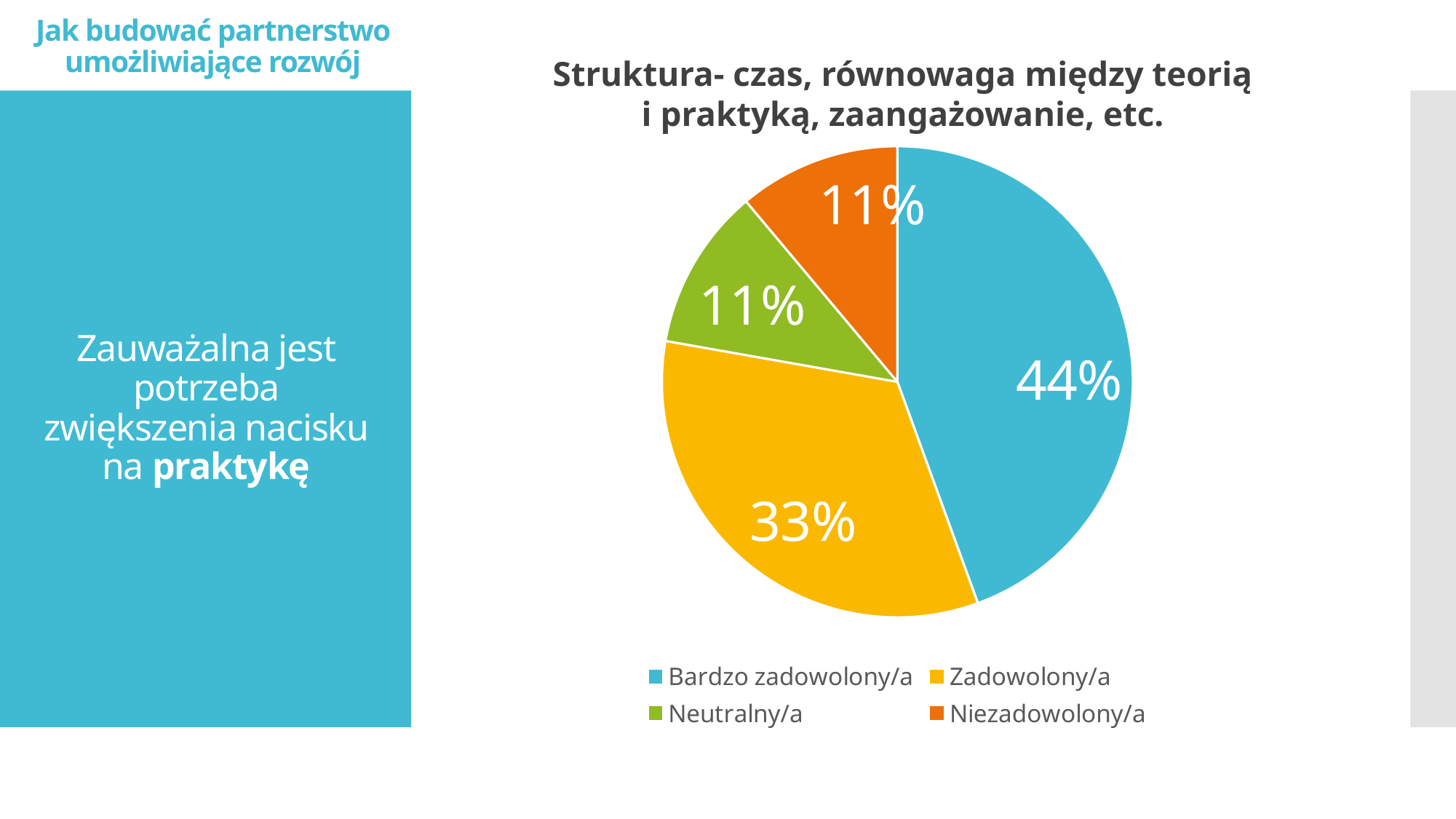
What is the difference in percentage points between Bardzo zadowolony/a and Zadowolony/a? 11 How many slices does the pie chart have? 4 What share of the pie is labelled Niezadowolony/a? 11% What is the title of the pie chart? Struktura- czas, równowaga między teorią i praktyką, zaangażowanie, etc. What share of the pie is labelled Zadowolony/a? 33% Which category has the largest slice of the pie? Bardzo zadowolony/a How many entries does the legend list? 4 What kind of chart is shown on the slide? pie chart What share of the pie is labelled Neutralny/a? 11% What colour is the Niezadowolony/a slice? orange Which is larger, the Zadowolony/a slice or the Neutralny/a slice? Zadowolony/a